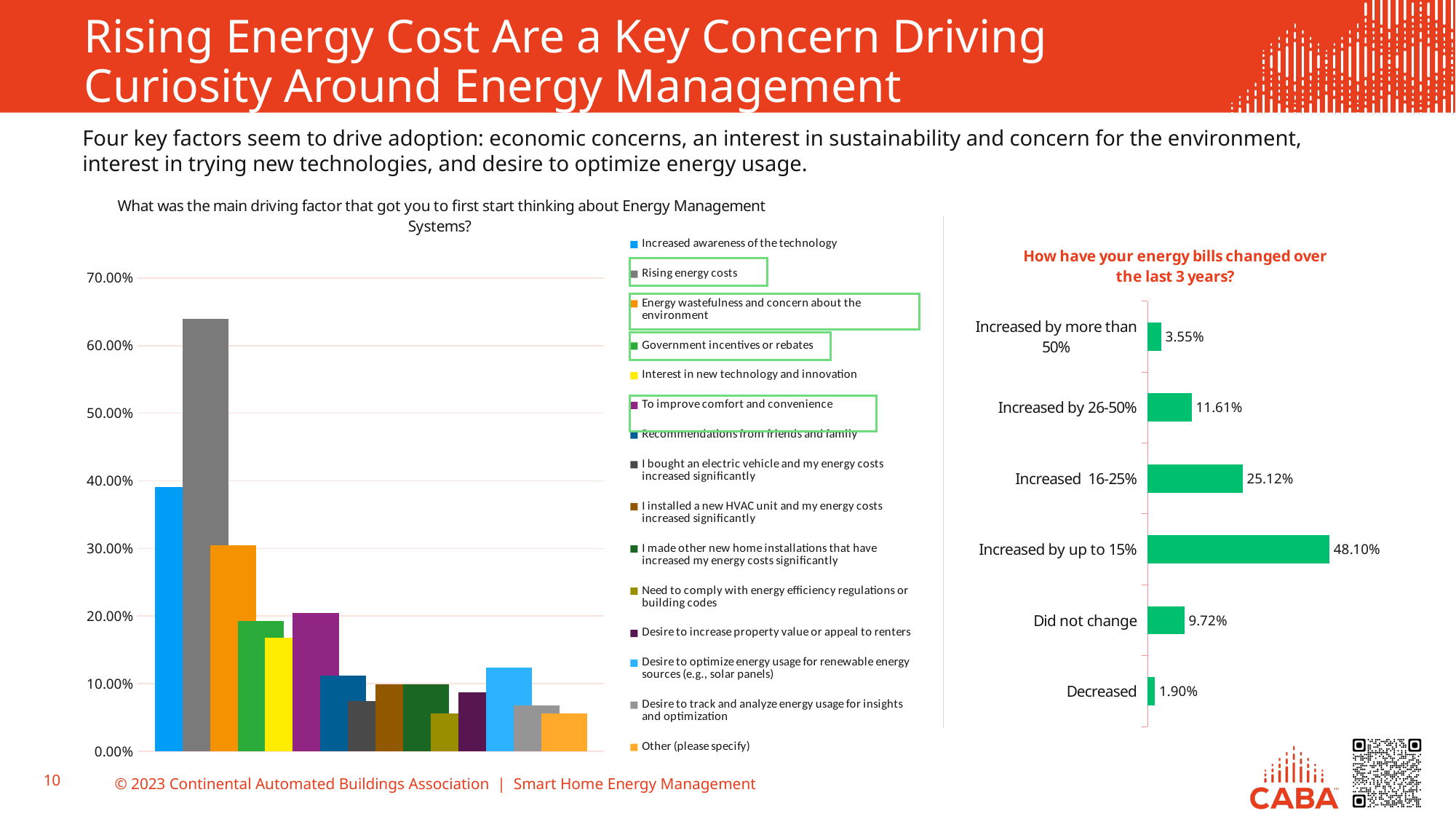
On the chart 'How have your energy bills changed over the last 3 years?', what is the value for 'Increased by up to 15%'? 48.10% How many entries does the legend of the left chart about the main driving factor for Energy Management Systems list? 15 On the chart 'How have your energy bills changed over the last 3 years?', which is larger: 'Increased by 26-50%' or 'Did not change'? Increased by 26-50% On the chart 'How have your energy bills changed over the last 3 years?', which category has the highest value? Increased by up to 15% On the chart 'How have your energy bills changed over the last 3 years?', which category has the lowest value? Decreased What kind of chart is the one on the left, 'What was the main driving factor that got you to first start thinking about Energy Management Systems?'? bar chart On the left chart about the main driving factor for Energy Management Systems, is the value for 'Rising energy costs' greater or less than 60.00%? greater On the chart 'How have your energy bills changed over the last 3 years?', what is the difference between 'Increased by up to 15%' and 'Increased 16-25%'? 22.98% On the chart 'How have your energy bills changed over the last 3 years?', what is the value for 'Did not change'? 9.72% On the left chart about the main driving factor for Energy Management Systems, which legend entry has the tallest bar? Rising energy costs How many categories are shown on the chart 'How have your energy bills changed over the last 3 years?'? 6